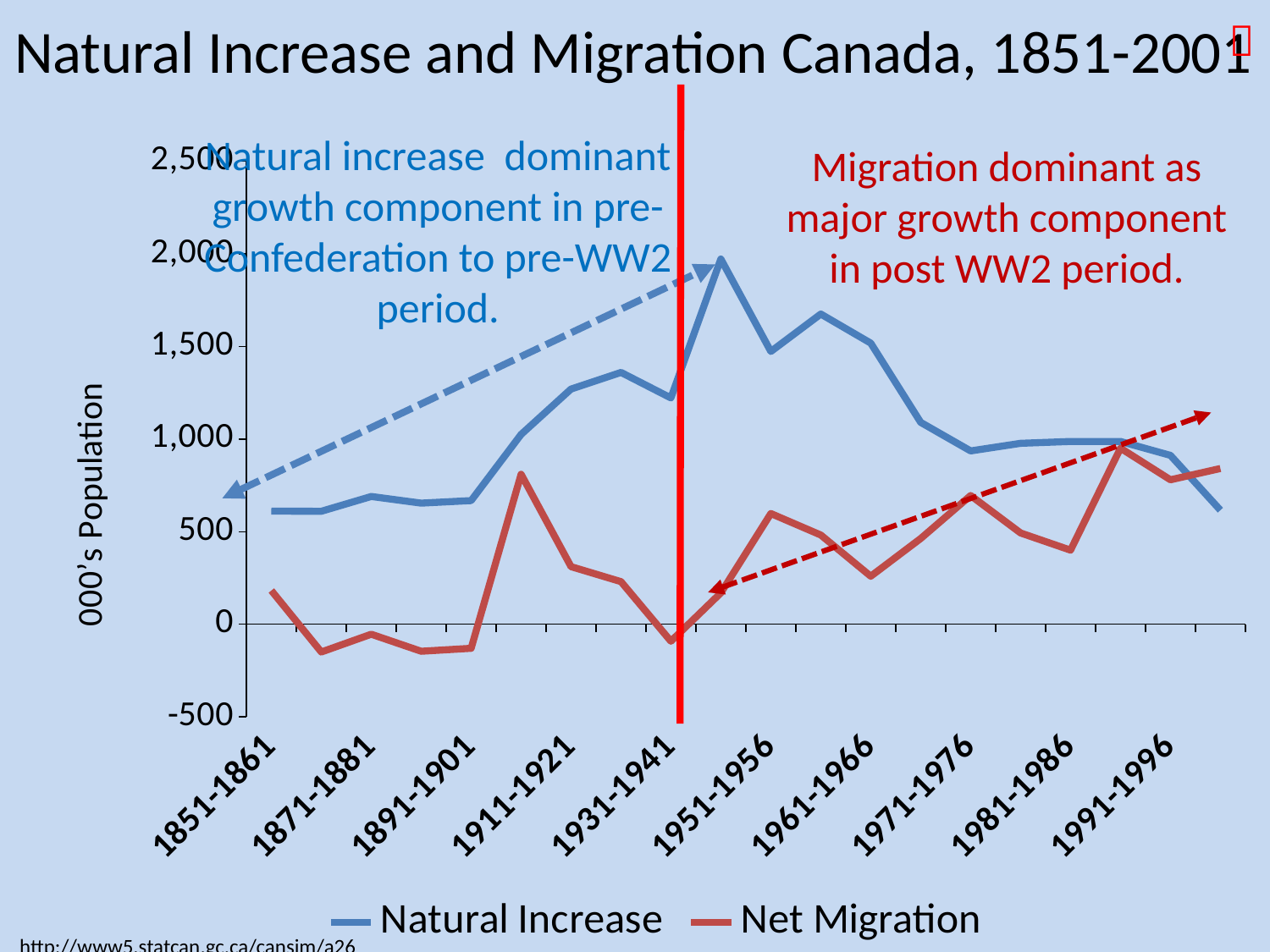
How many series does the legend list? 2 Which series has the higher value for 1961-1966, Natural Increase or Net Migration? Natural Increase Does the Natural Increase line generally rise or fall from 1961-1966 to 1991-1996? Fall Is the Net Migration value for 1871-1881 greater or less than 0? less What are the two series named in the legend? Natural Increase and Net Migration Is the Natural Increase value for 1931-1941 greater or less than 1,000? greater Is the Natural Increase value for 1851-1861 greater or less than 500? greater Does the Net Migration line generally rise or fall from 1951-1956 to 1991-1996? Rise What is the label on the vertical axis? 000's Population What kind of chart is shown on the slide? Line chart